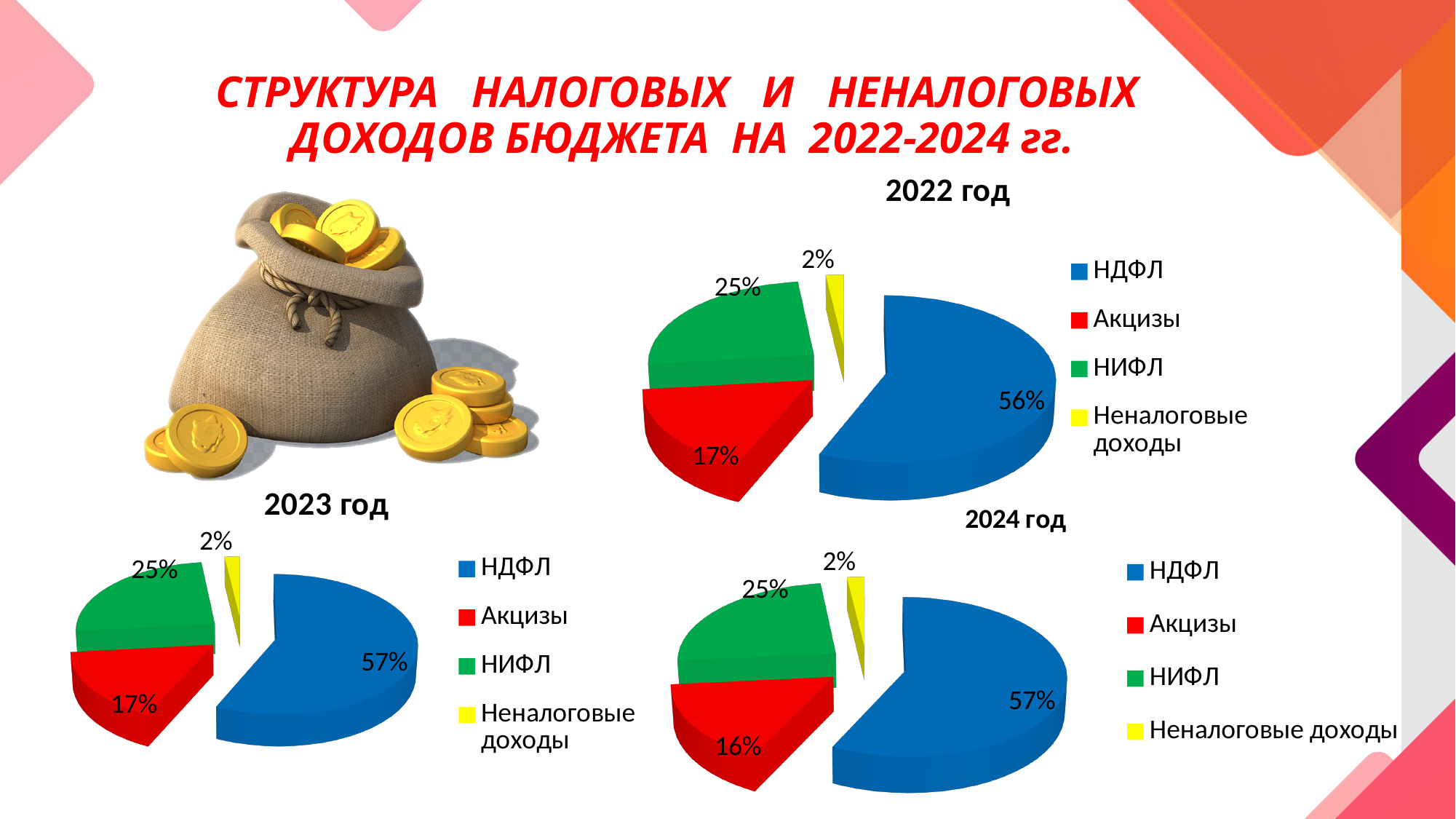
In the "2024 год" chart, what share does Акцизы have? 16% In the "2023 год" chart, what share does Акцизы have? 17% In the "2022 год" chart, what share does НДФЛ have? 56% What type of chart is the "2024 год" chart? Pie chart In the "2024 год" chart, what share does НИФЛ have? 25% How many entries does the legend of the "2022 год" chart list? 4 In the "2023 год" chart, which category has the smallest slice? Неналоговые доходы In the "2022 год" chart, which category has the largest slice? НДФЛ In the "2022 год" chart, what is the difference between the НДФЛ share and the НИФЛ share? 31% How many slices does the "2023 год" pie chart have? 4 In the "2023 год" chart, what colour is the slice for Неналоговые доходы? Yellow In the "2024 год" chart, which is larger: the share for НИФЛ or the share for Акцизы? НИФЛ